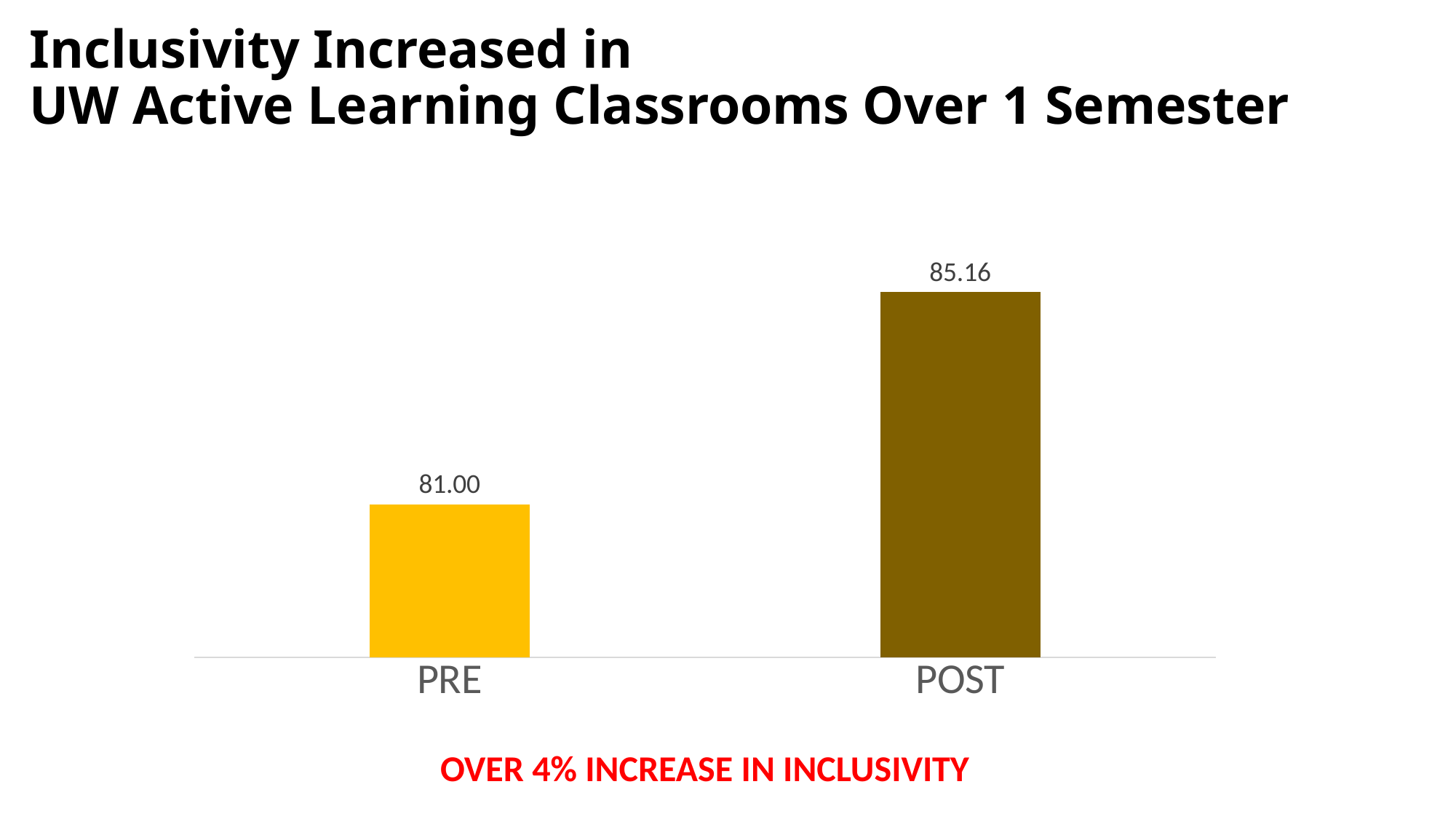
What is the value for POST? 85.16 Which is larger, the value for PRE or the value for POST? POST What kind of chart is shown on the slide? Bar chart Which category has the lowest value? PRE What is the value for PRE? 81.00 Which category has the highest value? POST What does the red text below the chart say? OVER 4% INCREASE IN INCLUSIVITY Do the values rise or fall from PRE to POST? Rise What is the title of the slide? Inclusivity Increased in UW Active Learning Classrooms Over 1 Semester What is the difference between the POST and PRE values? 4.16 How many categories are shown on the chart? 2